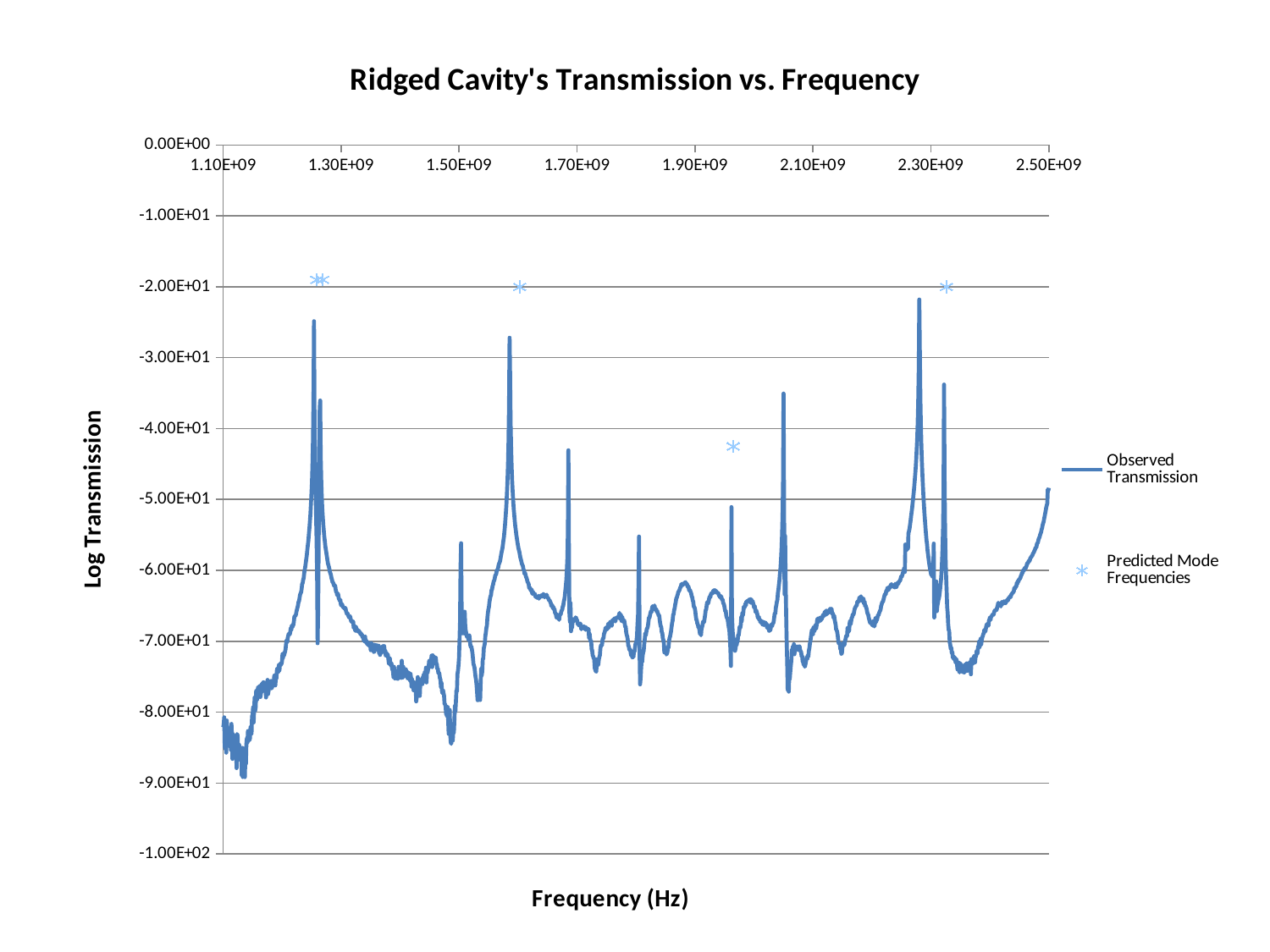
Is the Predicted Mode Frequencies marker located between 1.90E+09 and 2.10E+09 Hz greater or less than -4.00E+01? less Is the Observed Transmission value at 1.10E+09 Hz greater or less than -8.00E+01? less Is the lowest point of the Observed Transmission line greater or less than -8.00E+01? less Which Observed Transmission peak is higher: the one near 1.30E+09 Hz or the one near 2.30E+09 Hz? the one near 2.30E+09 Hz What is the label of the y axis? Log Transmission How many series does the chart's legend list? 2 Between 2.40E+09 and 2.50E+09 Hz, does the Observed Transmission line rise or fall? rise What is the title of the chart? Ridged Cavity's Transmission vs. Frequency What kind of chart is shown on the slide? line chart